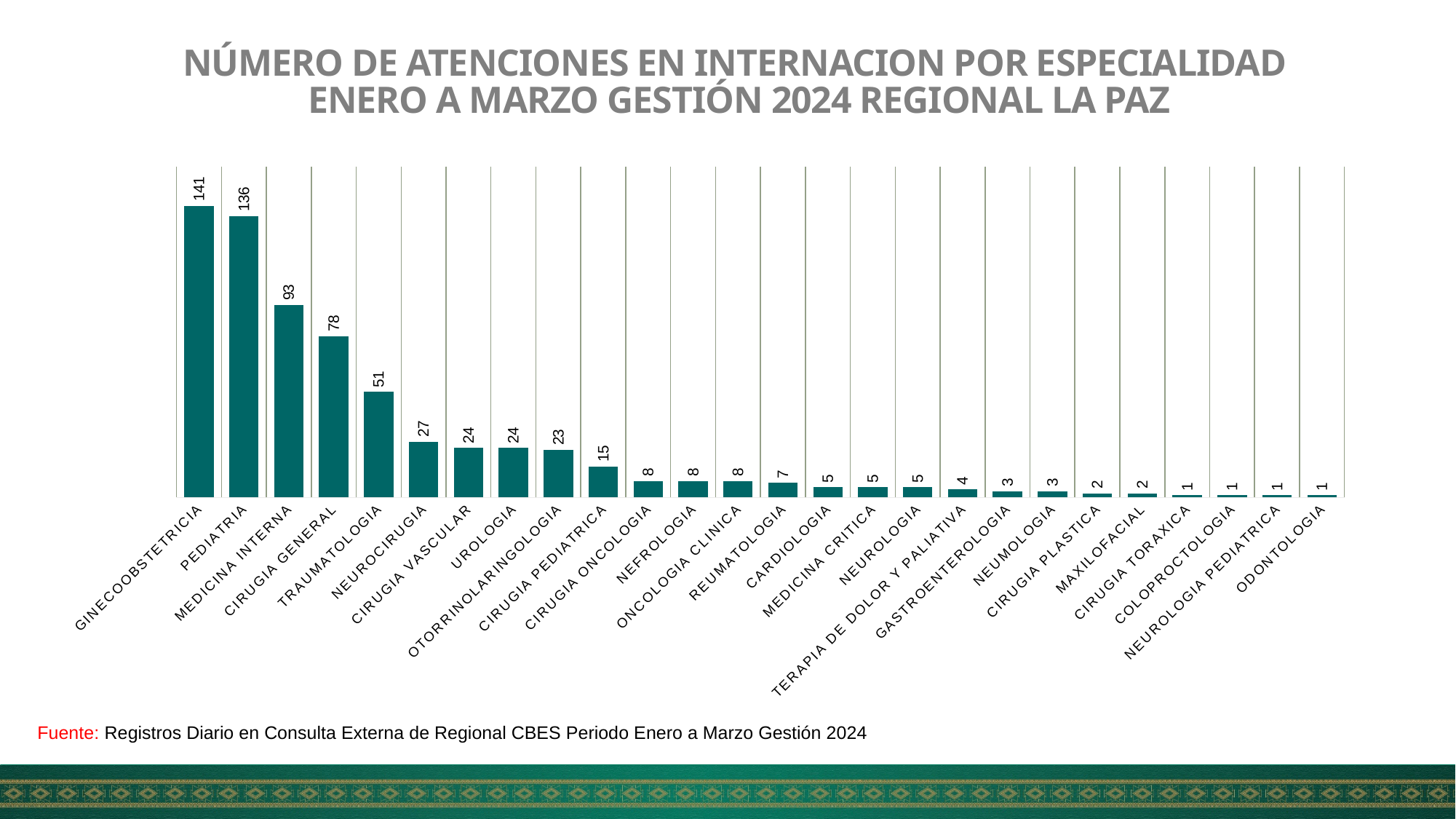
What is the value for OTORRINOLARINGOLOGIA? 23 Do the values rise or fall from left to right along the x axis? Fall What is the difference between the values for GINECOOBSTETRICIA and PEDIATRIA? 5 Which specialty has the highest number of atenciones? GINECOOBSTETRICIA Which is larger, the value for NEUROCIRUGIA or the value for CIRUGIA PEDIATRICA? NEUROCIRUGIA What is the value for TRAUMATOLOGIA? 51 What is the difference between the values for MEDICINA INTERNA and CIRUGIA GENERAL? 15 How many specialties are shown on the chart? 26 What kind of chart is shown on the slide? Bar chart What is the value for TERAPIA DE DOLOR Y PALIATIVA? 4 What is the title of the chart? NÚMERO DE ATENCIONES EN INTERNACION POR ESPECIALIDAD ENERO A MARZO GESTIÓN 2024 REGIONAL LA PAZ What is the value for PEDIATRIA? 136